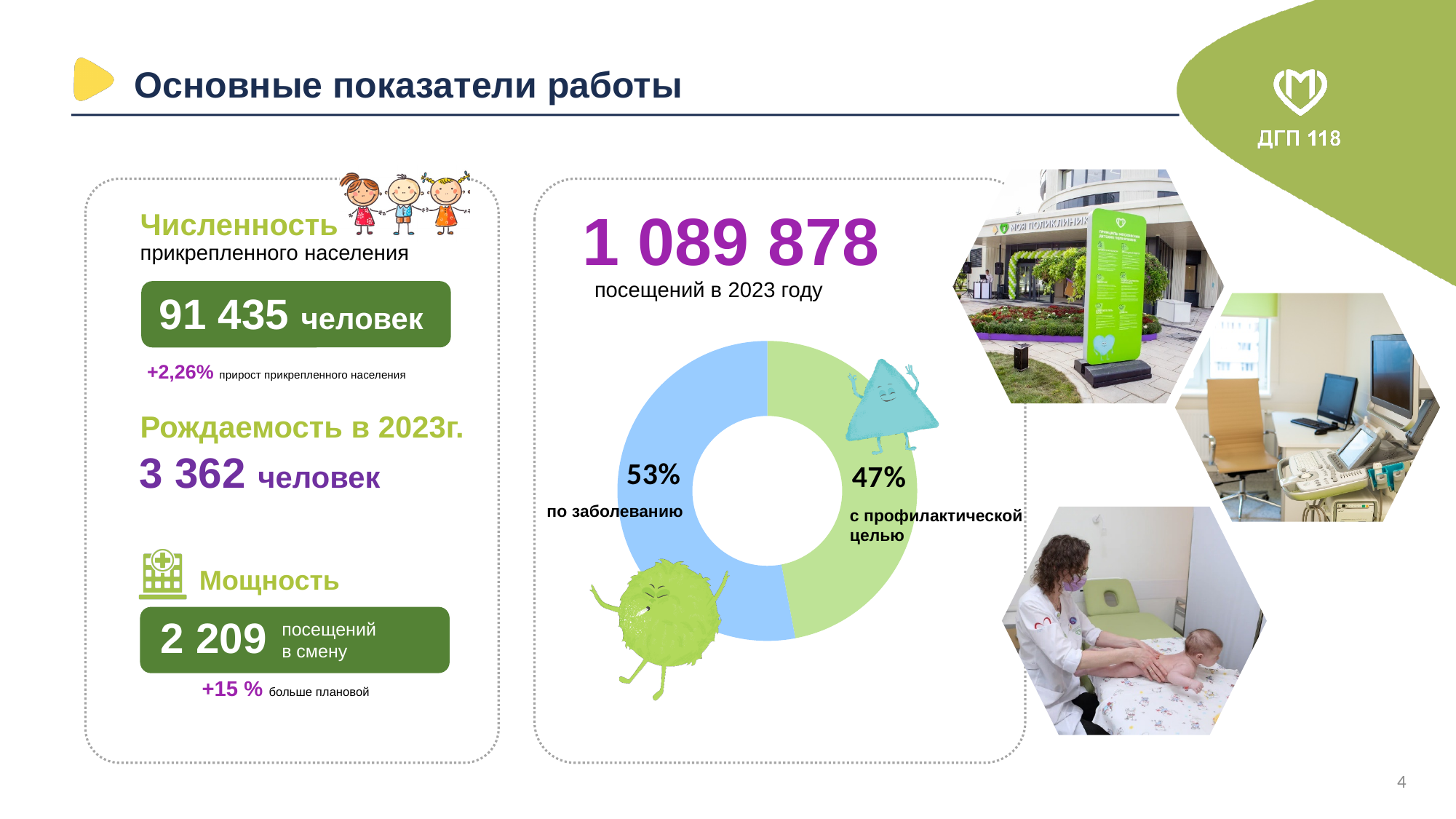
What share of visits is labelled "с профилактической целью" in the donut chart? 47% Is the share of visits "с профилактической целью" greater or less than 50%? less What kind of chart is shown on the slide? Pie (donut) chart How many slices does the donut chart have? 2 Which slice of the donut chart is the smallest? с профилактической целью Which slice of the donut chart is the largest? по заболеванию What colour is the "по заболеванию" slice of the donut chart? Blue By how many percentage points does the "по заболеванию" slice exceed the "с профилактической целью" slice? 6 percentage points What total number of visits in 2023 is shown above the donut chart? 1 089 878 What share of visits is labelled "по заболеванию" in the donut chart? 53% Which is larger in the donut chart: the share of visits "по заболеванию" or "с профилактической целью"? по заболеванию